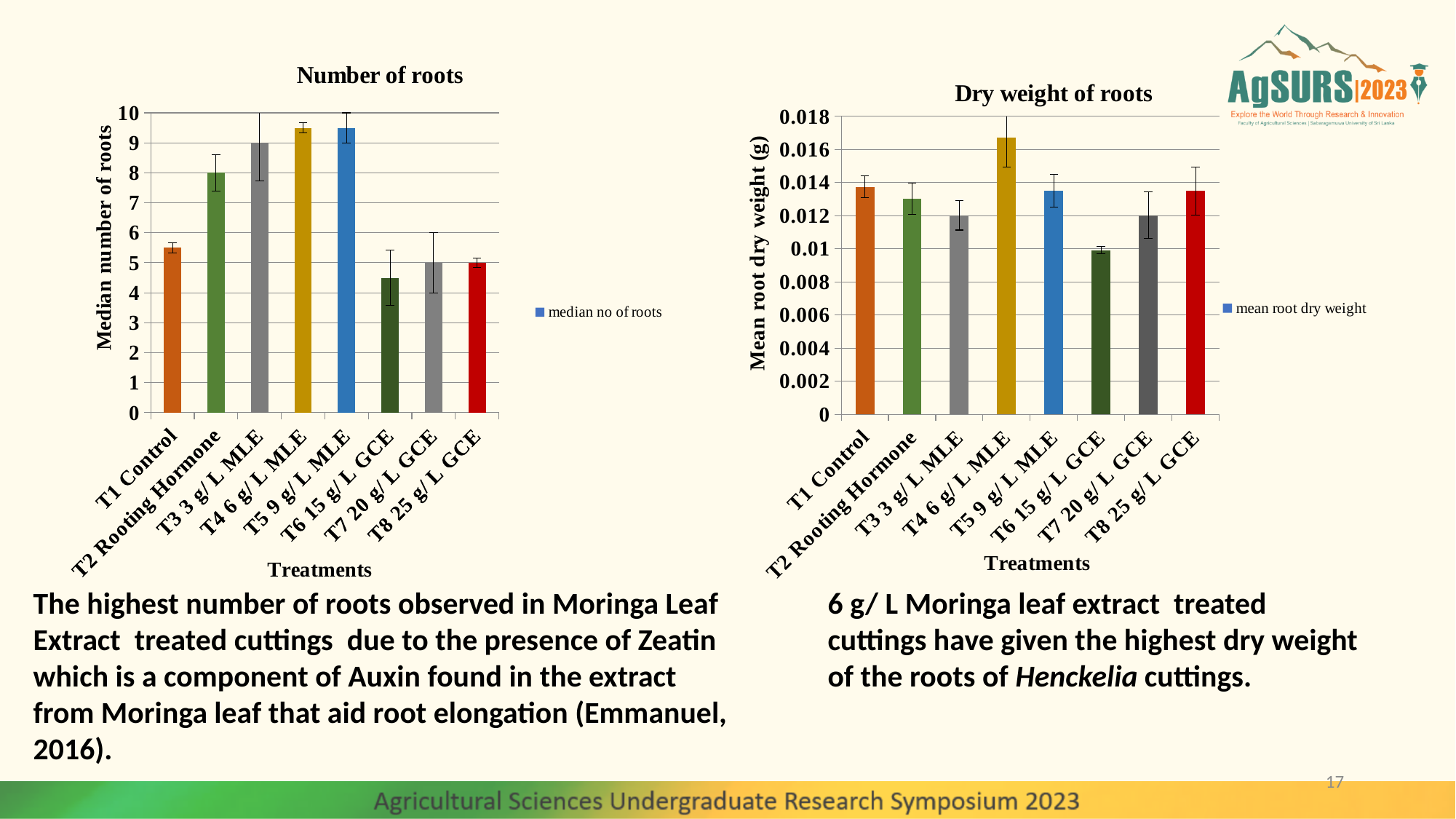
In the "Dry weight of roots" chart, is the value for T6 15 g/L GCE greater or less than 0.012? less In the "Dry weight of roots" chart, is the value for T4 6 g/L MLE greater or less than 0.016? greater In the "Dry weight of roots" chart, which treatment has the lowest mean root dry weight? T6 15 g/L GCE In the "Number of roots" chart, which has a higher median number of roots, T2 Rooting Hormone or T6 15 g/L GCE? T2 Rooting Hormone In the "Number of roots" chart, how many treatments are shown on the x axis? 8 How many series does the legend of the "Number of roots" chart list? 1 In the "Number of roots" chart, is the value for T6 15 g/L GCE greater or less than 5? less In the "Number of roots" chart, which treatment has the lowest median number of roots? T6 15 g/L GCE What is the legend entry of the "Dry weight of roots" chart? mean root dry weight What kind of chart is the "Number of roots" chart? bar chart In the "Dry weight of roots" chart, which treatment has the highest mean root dry weight? T4 6 g/L MLE